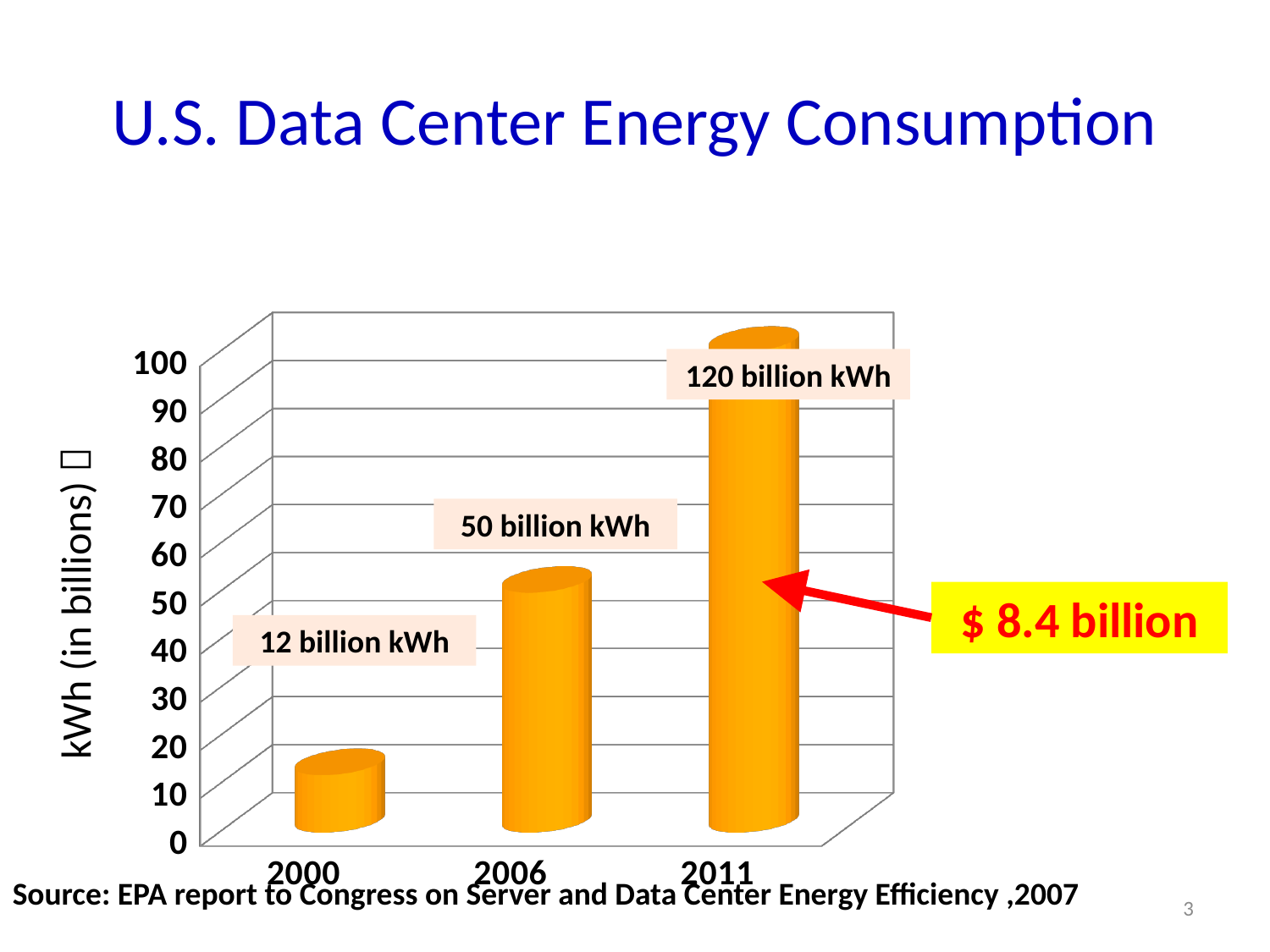
What is the title of the slide's chart? U.S. Data Center Energy Consumption Which year has the highest energy consumption? 2011 What is the difference between the labelled values for 2011 and 2006? 70 billion kWh Which is larger, the value for 2006 or the value for 2000? 2006 What is the difference between the labelled values for 2006 and 2000? 38 billion kWh What value is labelled for the year 2006? 50 billion kWh What value is labelled for the year 2000? 12 billion kWh What value is labelled for the year 2011? 120 billion kWh Which year has the lowest energy consumption? 2000 What kind of chart is shown on the slide? Bar chart How many years are shown on the x axis? 3 Do the values rise or fall from 2000 to 2011? Rise